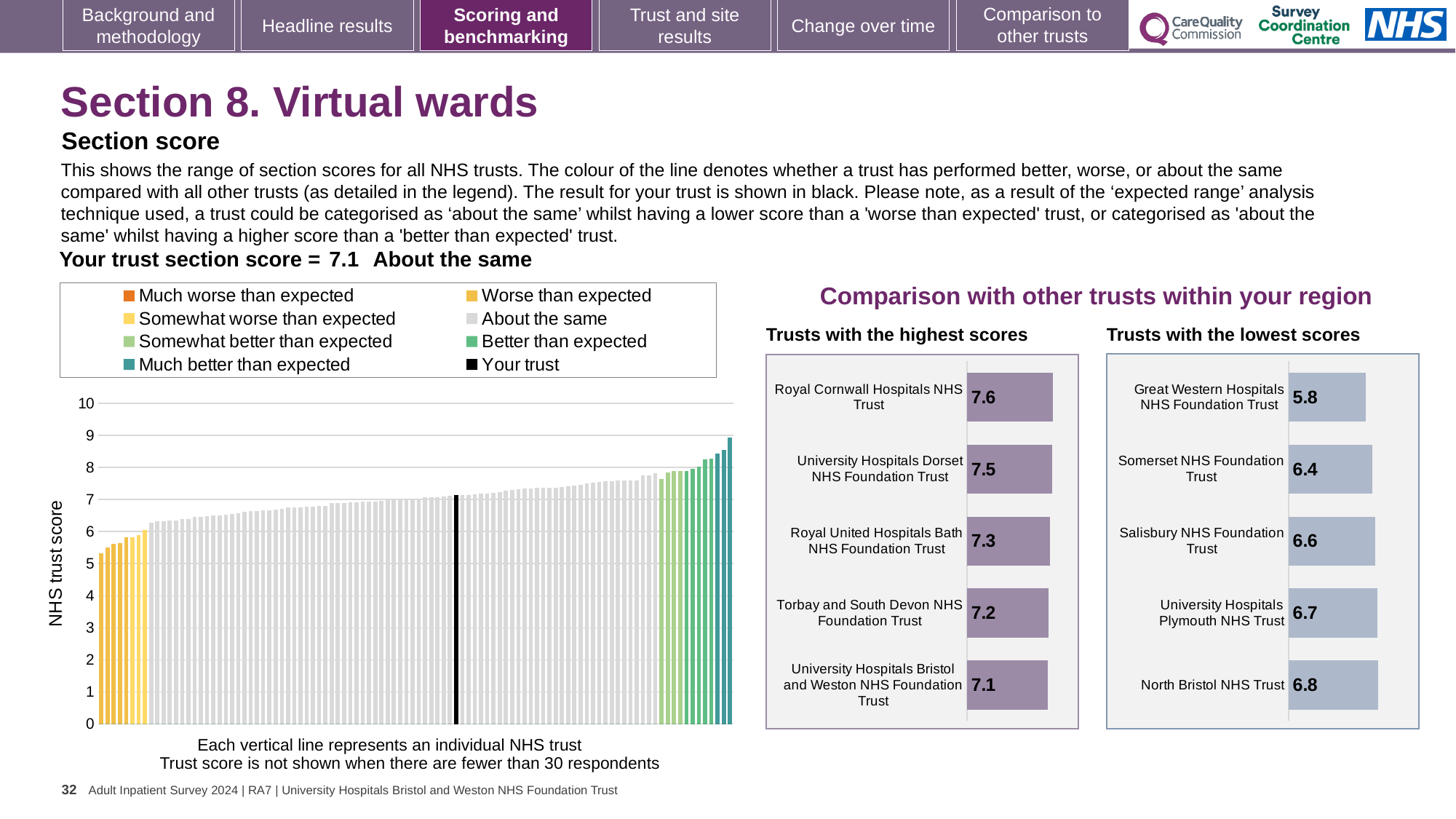
How many entries does the legend of the main 'NHS trust score' chart list? 8 In the 'Trusts with the lowest scores' chart, which has the larger score: Somerset NHS Foundation Trust or Salisbury NHS Foundation Trust? Salisbury NHS Foundation Trust How many trusts are listed in the 'Trusts with the lowest scores' chart? 5 In the main 'NHS trust score' chart on the left, is the value of the tallest bar greater or less than 8? greater In the main 'NHS trust score' chart on the left, do the bar values rise or fall from left to right? rise In the 'Trusts with the lowest scores' chart, what is the score for University Hospitals Plymouth NHS Trust? 6.7 In the 'Trusts with the highest scores' chart, which trust has the lowest score shown? University Hospitals Bristol and Weston NHS Foundation Trust In the 'Trusts with the highest scores' chart, what is the difference between the scores of Royal Cornwall Hospitals NHS Trust and Torbay and South Devon NHS Foundation Trust? 0.4 In the 'Trusts with the highest scores' chart, what is the score for Royal Cornwall Hospitals NHS Trust? 7.6 What kind of chart is the 'Trusts with the highest scores' chart? bar chart In the 'Trusts with the lowest scores' chart, which trust has the highest score shown? North Bristol NHS Trust In the 'Trusts with the lowest scores' chart, what is the score for Great Western Hospitals NHS Foundation Trust? 5.8